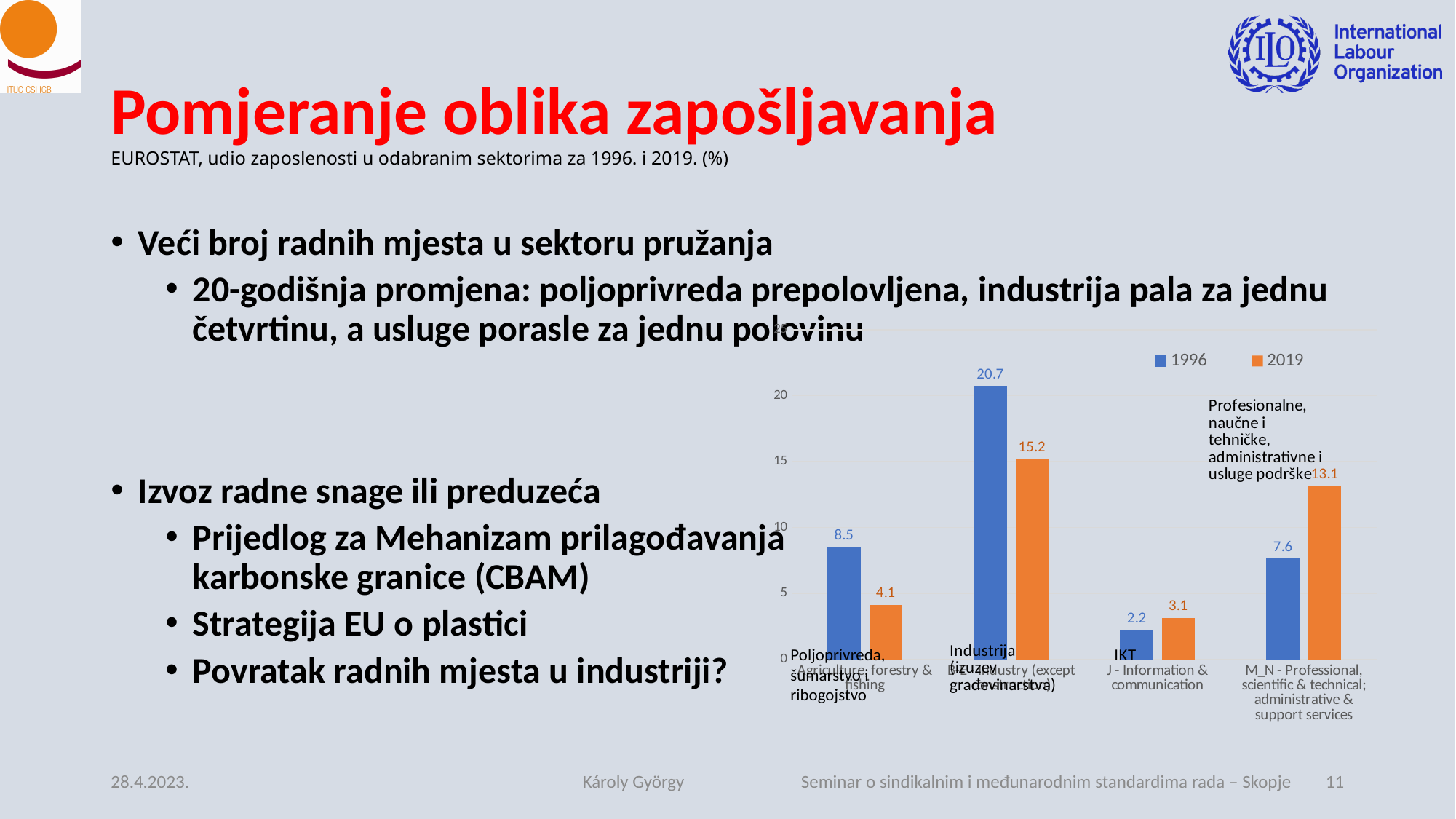
What is the 1996 value for Industry (except construction)? 20.7 How many categories are shown on the x axis of the chart? 4 How many series does the chart legend list? 2 Which category has the lowest 2019 value? Information & communication Which category has the highest 1996 value? Industry (except construction) What is the difference between the 1996 and 2019 values for Industry (except construction)? 5.5 What is the 2019 value for Agriculture, forestry & fishing? 4.1 Which colour represents the 2019 series in the chart? orange What is the 2019 value for Information & communication? 3.1 What kind of chart is shown on the slide? bar chart Which is larger for Professional, scientific & technical; administrative & support services: the 1996 value or the 2019 value? 2019 What is the 1996 value for Professional, scientific & technical; administrative & support services? 7.6